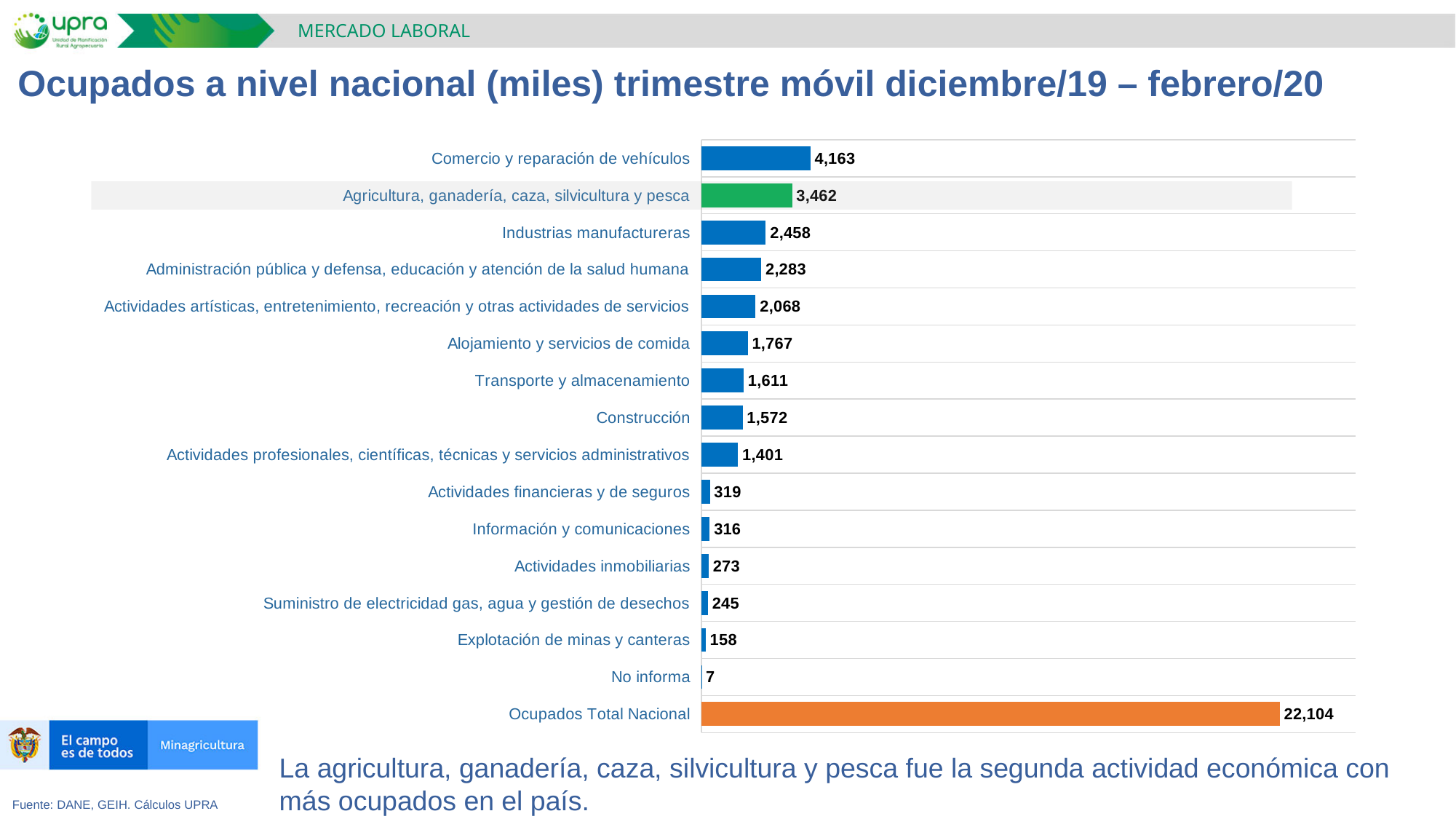
What is the value for Comercio y reparación de vehículos? 4,163 Excluding the Ocupados Total Nacional bar, which category has the highest value? Comercio y reparación de vehículos What is the value for Agricultura, ganadería, caza, silvicultura y pesca? 3,462 What is the value for Explotación de minas y canteras? 158 What is the difference between Comercio y reparación de vehículos and Agricultura, ganadería, caza, silvicultura y pesca? 701 How many bars are shown in the chart, including Ocupados Total Nacional? 16 Which is larger, Alojamiento y servicios de comida or Construcción? Alojamiento y servicios de comida What type of chart is shown on the slide? Bar chart What is the difference between Industrias manufactureras and Administración pública y defensa, educación y atención de la salud humana? 175 Which category has the lowest value? No informa What is the value for Ocupados Total Nacional? 22,104 Which bar in the chart is coloured green? Agricultura, ganadería, caza, silvicultura y pesca